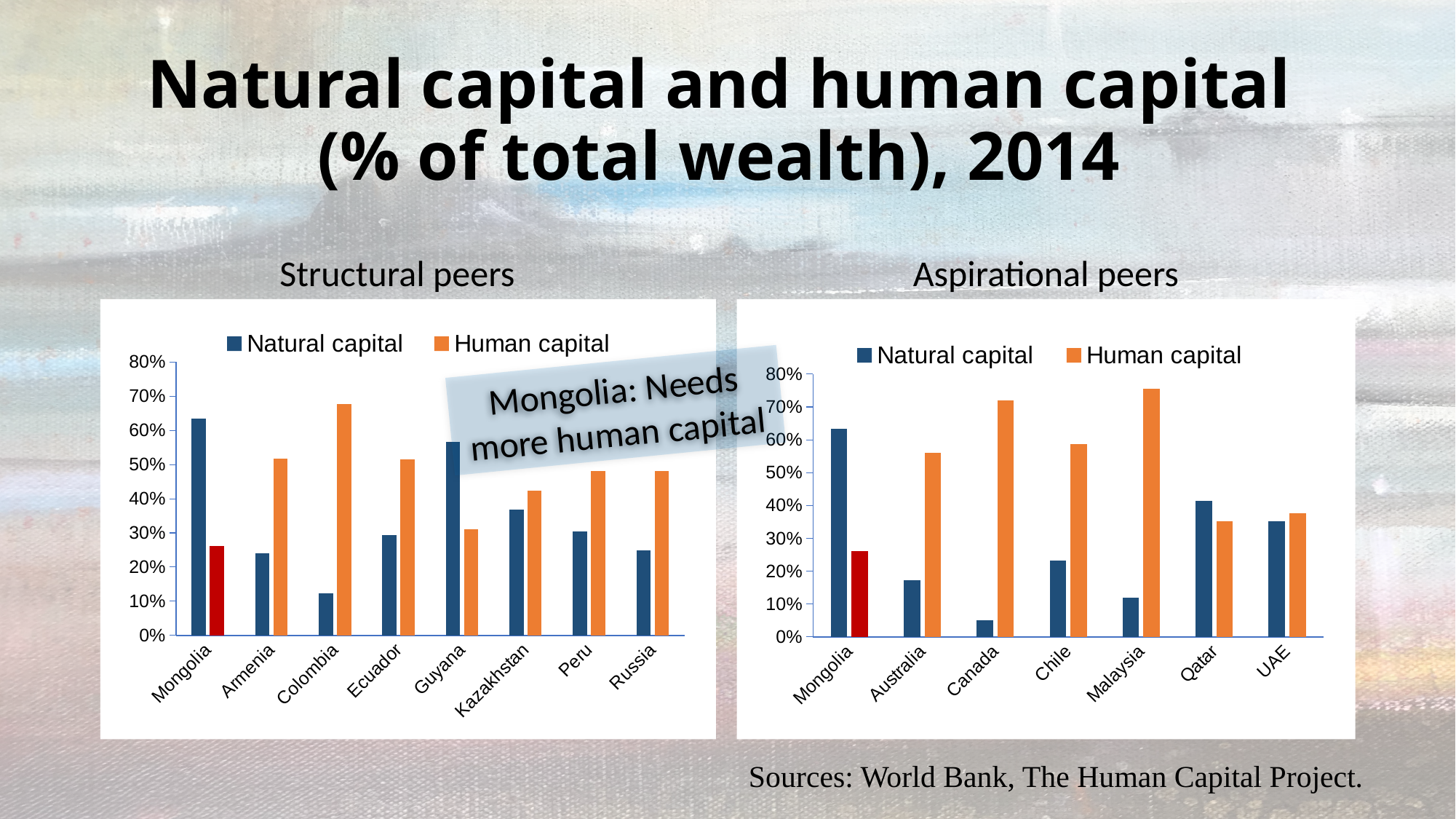
On the Aspirational peers chart, which country has the lowest human capital share? Mongolia On the Aspirational peers chart, which country has the lowest natural capital share? Canada How many series does the legend of the Aspirational peers chart list? 2 What kind of chart is the Structural peers chart? bar chart On the Structural peers chart, is the natural capital value for Mongolia greater or less than 60%? greater On the Structural peers chart, which country has the highest natural capital share? Mongolia On the Structural peers chart, which country has the lowest natural capital share? Colombia On the Aspirational peers chart, is the natural capital value for Canada greater or less than 10%? less On the Structural peers chart, which country has the highest human capital share? Colombia On the Aspirational peers chart, is Qatar's natural capital or human capital share larger? Natural capital How many countries are shown on the Structural peers chart? 8 How many countries are shown on the Aspirational peers chart? 7